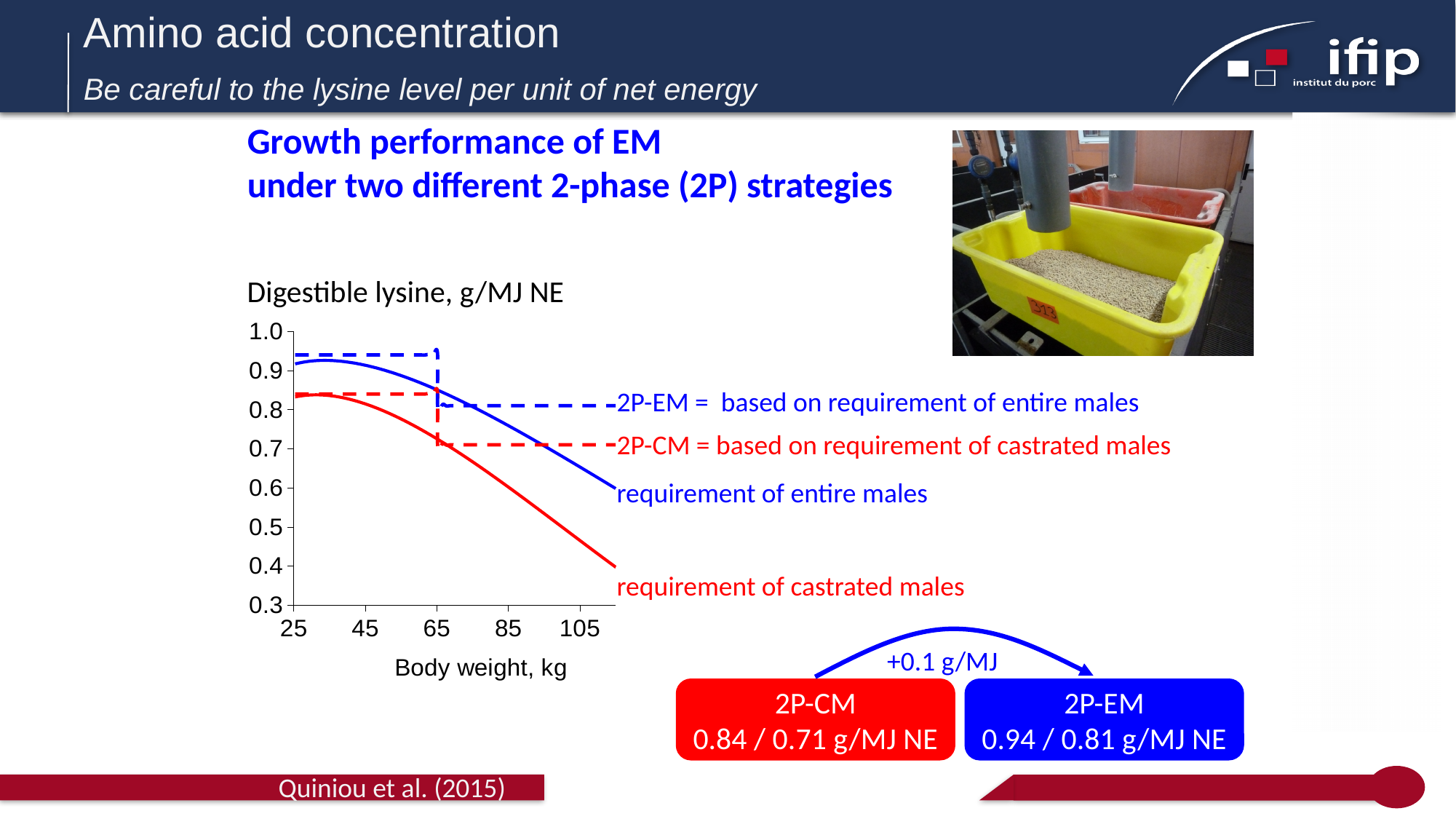
Is the requirement of castrated males at 105 kg body weight greater or less than 0.5 g/MJ NE? less What is the digestible lysine level of the 2P-CM strategy in the first phase (before 65 kg)? 0.84 g/MJ NE What is the label of the x axis of the chart? Body weight, kg What is the digestible lysine level of the 2P-CM strategy in the second phase (after 65 kg)? 0.71 g/MJ NE Which strategy has the higher digestible lysine level in the second phase, 2P-EM or 2P-CM? 2P-EM Does the requirement of entire males rise or fall as body weight increases from 45 kg to 105 kg? fall What quantity is plotted on the y axis of the chart? Digestible lysine, g/MJ NE Is the requirement of entire males at 105 kg body weight greater or less than 0.5 g/MJ NE? greater What is the difference in digestible lysine between the 2P-EM and 2P-CM strategies in the first phase? 0.1 g/MJ What is the digestible lysine level of the 2P-EM strategy in the first phase (before 65 kg)? 0.94 g/MJ NE What kind of chart is shown on the slide? line chart How many lines (series) are labelled on the chart? 4